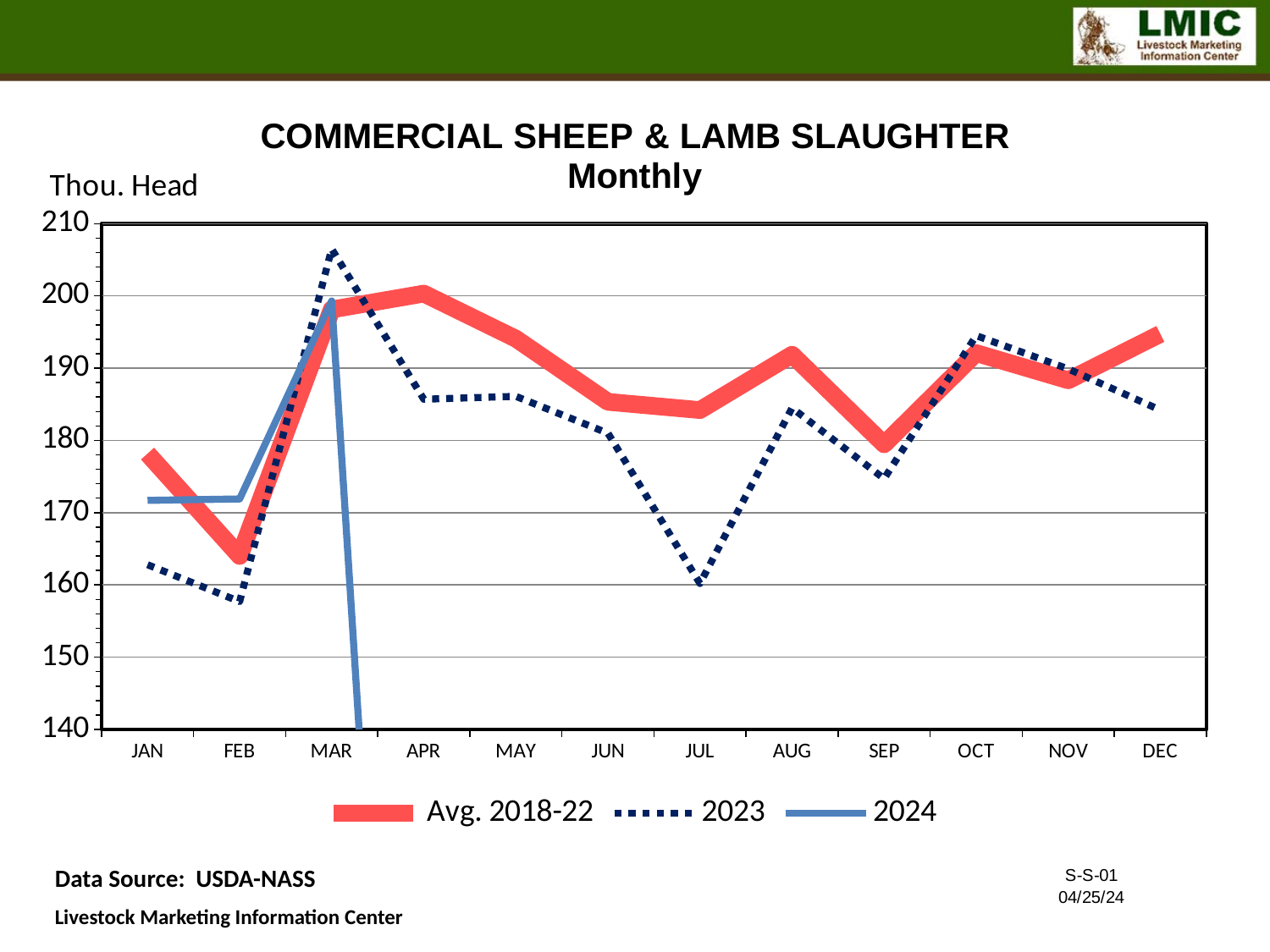
What kind of chart is shown on the slide? Line chart What is the data source named on the slide? USDA-NASS How many series does the legend list? 3 Is the 2023 value for JUL greater or less than 170? less Does the 2024 series rise or fall from JAN to MAR? Rise Is the 2023 value for MAR greater or less than 200? greater What unit is shown on the y axis? Thou. Head In which month is the Avg. 2018-22 series at its lowest? FEB In which month does the 2023 series reach its highest value? MAR How many months are shown along the x axis? 12 Is the 2024 value for JAN greater or less than 180? less Which is larger in JUL, the Avg. 2018-22 value or the 2023 value? Avg. 2018-22